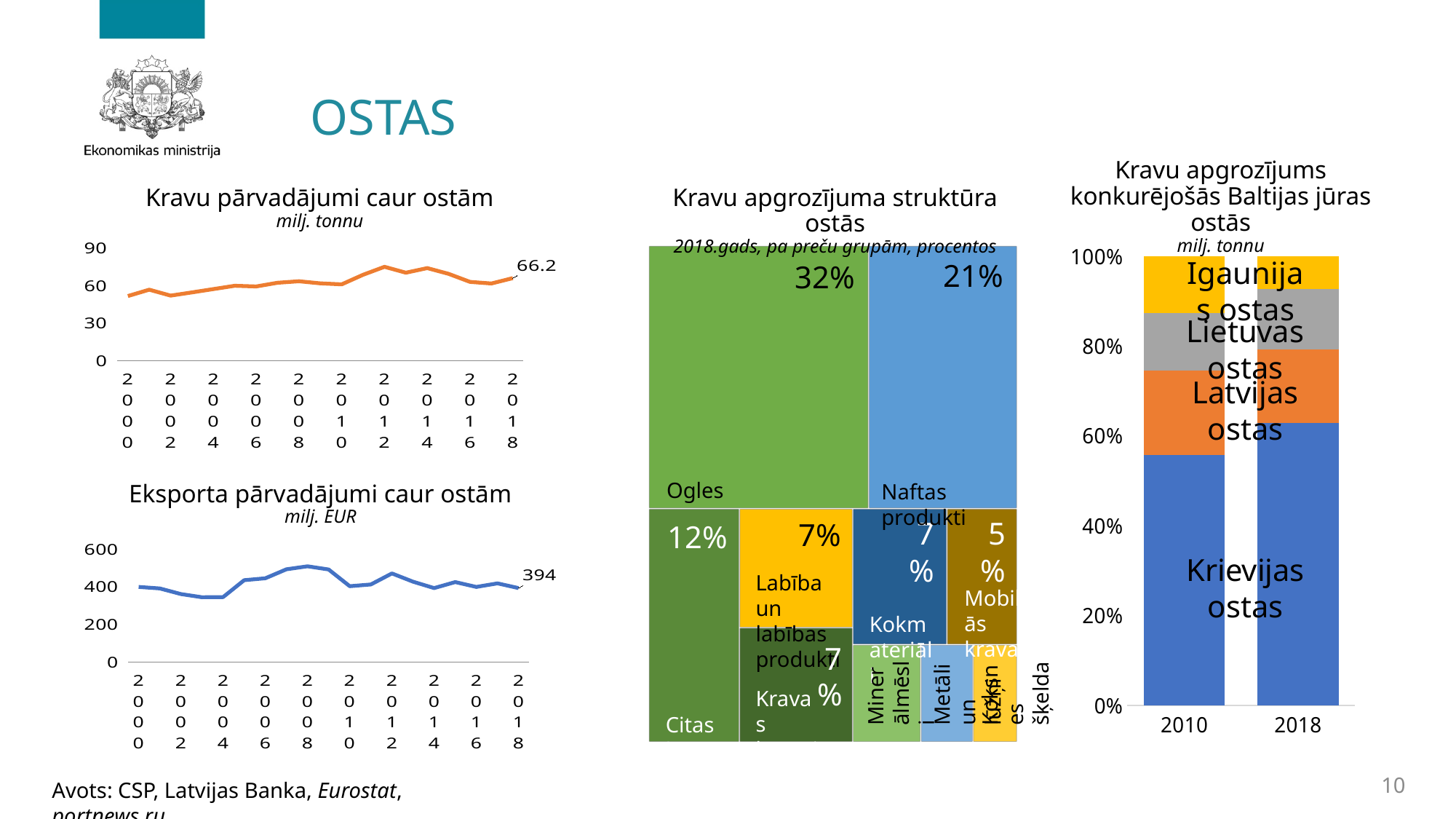
In the chart 'Kravu pārvadājumi caur ostām', what value is labelled for 2018? 66.2 In the chart 'Eksporta pārvadājumi caur ostām', is the value for 2008 greater or less than 400? greater How many years are plotted on the x axis of the chart 'Eksporta pārvadājumi caur ostām'? 10 In the chart 'Kravu apgrozījuma struktūra ostās', what is the difference in percentage points between Ogles and Naftas produkti? 11 In the chart 'Kravu apgrozījuma struktūra ostās', what share does Naftas produkti have? 21% In the chart 'Kravu apgrozījums konkurējošās Baltijas jūras ostās', how many years are shown on the x axis? 2 In the chart 'Kravu pārvadājumi caur ostām', is the value for 2000 greater or less than 60? less What kind of chart is 'Kravu pārvadājumi caur ostām'? line chart In the chart 'Kravu apgrozījuma struktūra ostās', what share does Ogles have? 32% In the chart 'Eksporta pārvadājumi caur ostām', what value is labelled for 2018? 394 In the chart 'Kravu apgrozījums konkurējošās Baltijas jūras ostās', is the share of Krievijas ostas in 2010 greater or less than 60%? less In the chart 'Kravu apgrozījuma struktūra ostās', which product group has the largest share? Ogles